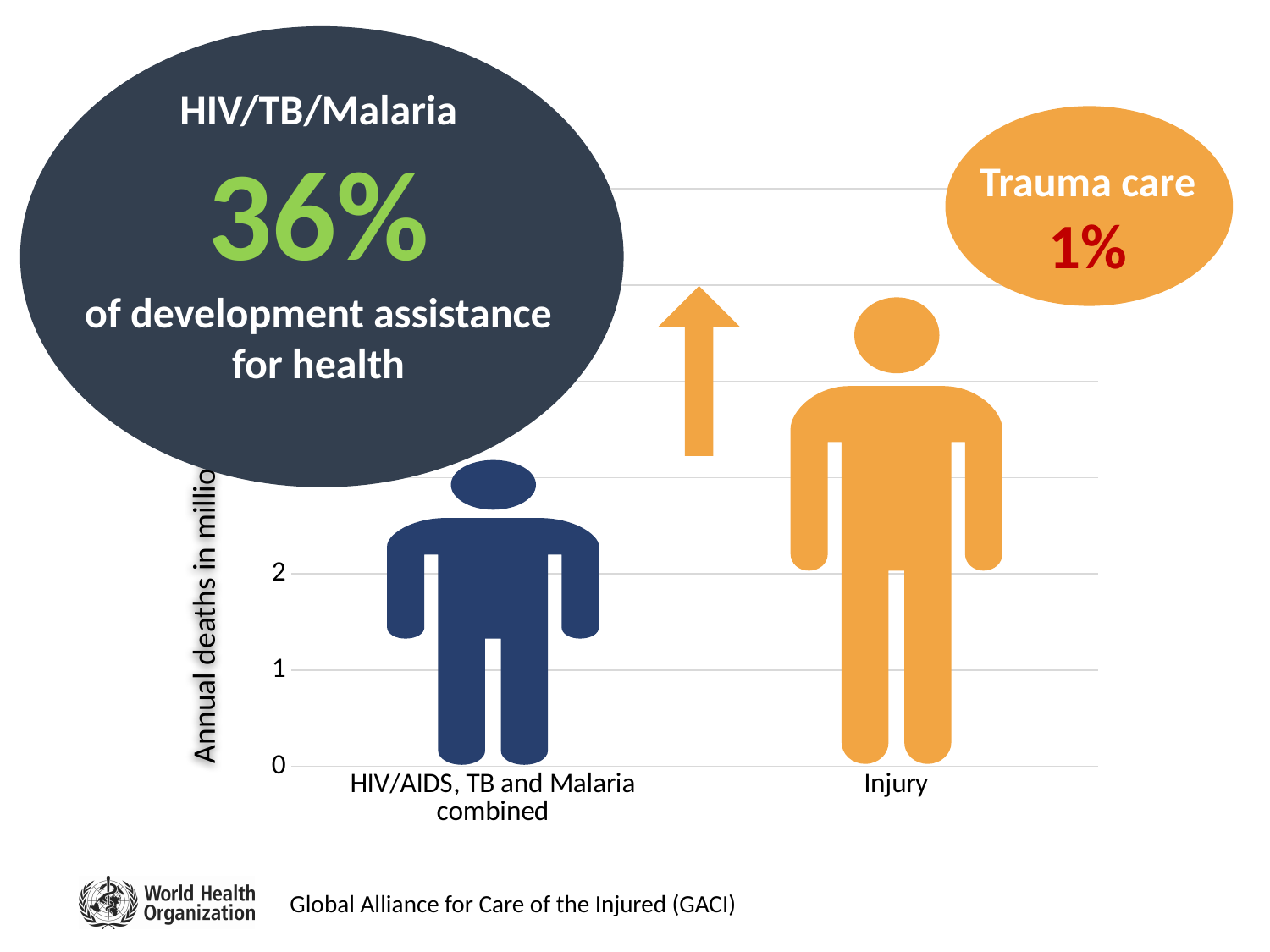
Which category has the lower number of annual deaths? HIV/AIDS, TB and Malaria combined What kind of chart is shown on the slide? bar chart Are annual deaths higher for Injury or for HIV/AIDS, TB and Malaria combined? Injury Is the value for HIV/AIDS, TB and Malaria combined greater or less than 2? greater Which category has the higher number of annual deaths? Injury Is the value for Injury greater or less than 2? greater What percentage of development assistance for health goes to HIV/TB/Malaria according to the slide? 36% Is the value for HIV/AIDS, TB and Malaria combined greater or less than 1? greater What percentage of development assistance for health goes to trauma care according to the slide? 1% How many categories are shown on the x axis of the chart? 2